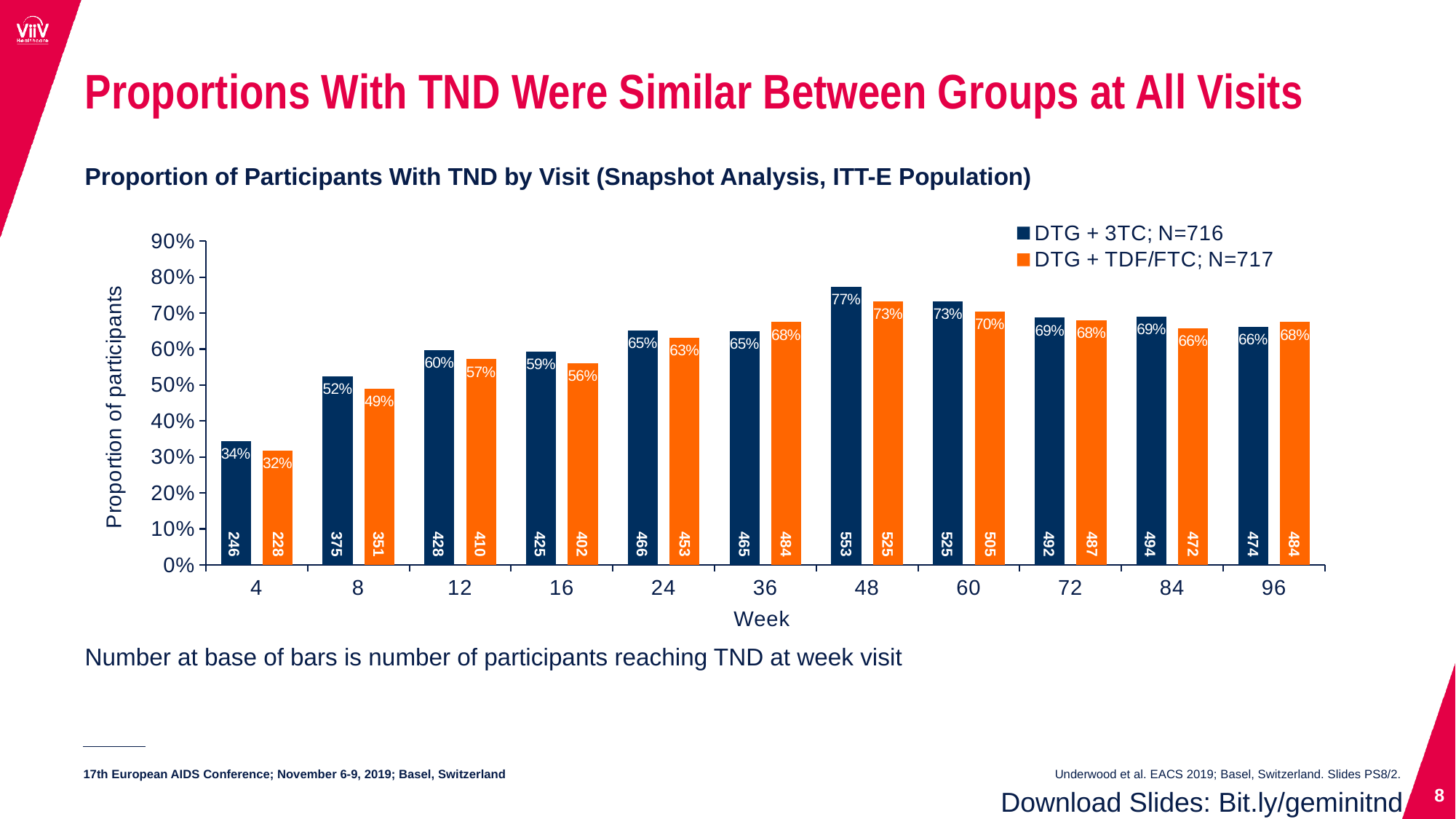
How many series does the legend list? 2 How many participants in the DTG + TDF/FTC group reached TND at week 96? 484 What kind of chart is shown? bar chart What is the value for DTG + 3TC at week 48? 77% What is the value for DTG + TDF/FTC at week 8? 49% How many week visits are shown on the x axis? 11 Is the value for DTG + 3TC at week 4 greater or less than 40%? less What is the difference between the DTG + 3TC and DTG + TDF/FTC values at week 48? 4% What is the N for the DTG + 3TC group shown in the legend? 716 At week 36, which group has the larger proportion, DTG + 3TC or DTG + TDF/FTC? DTG + TDF/FTC At which week is the DTG + TDF/FTC proportion lowest? 4 At which week is the DTG + 3TC proportion highest? 48